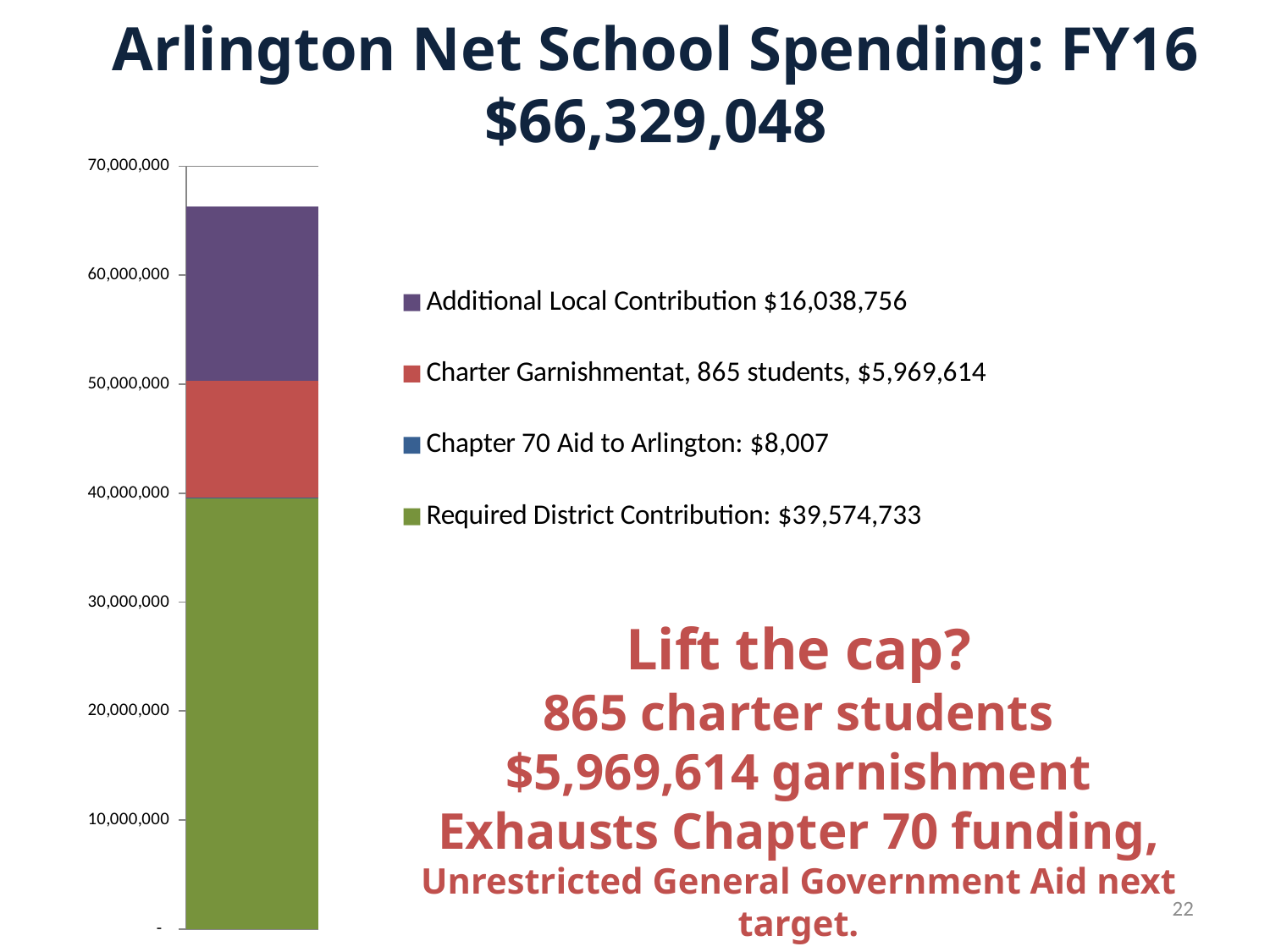
How many series does the chart legend list? 4 Which segment of the stacked bar has the largest value? Required District Contribution What kind of chart is shown on the slide? Stacked bar chart What is the value of the Chapter 70 Aid to Arlington segment? $8,007 Which is larger, the Additional Local Contribution or the Charter Garnishment? Additional Local Contribution What is the value of the Charter Garnishment segment? $5,969,614 How many bars are plotted in the chart? 1 What is the value of the Required District Contribution segment? $39,574,733 Which segment of the stacked bar has the smallest value? Chapter 70 Aid to Arlington What is the difference between the Additional Local Contribution and the Charter Garnishment? $10,069,142 Is the top of the stacked bar greater or less than 60,000,000? greater What is the value of the Additional Local Contribution segment? $16,038,756